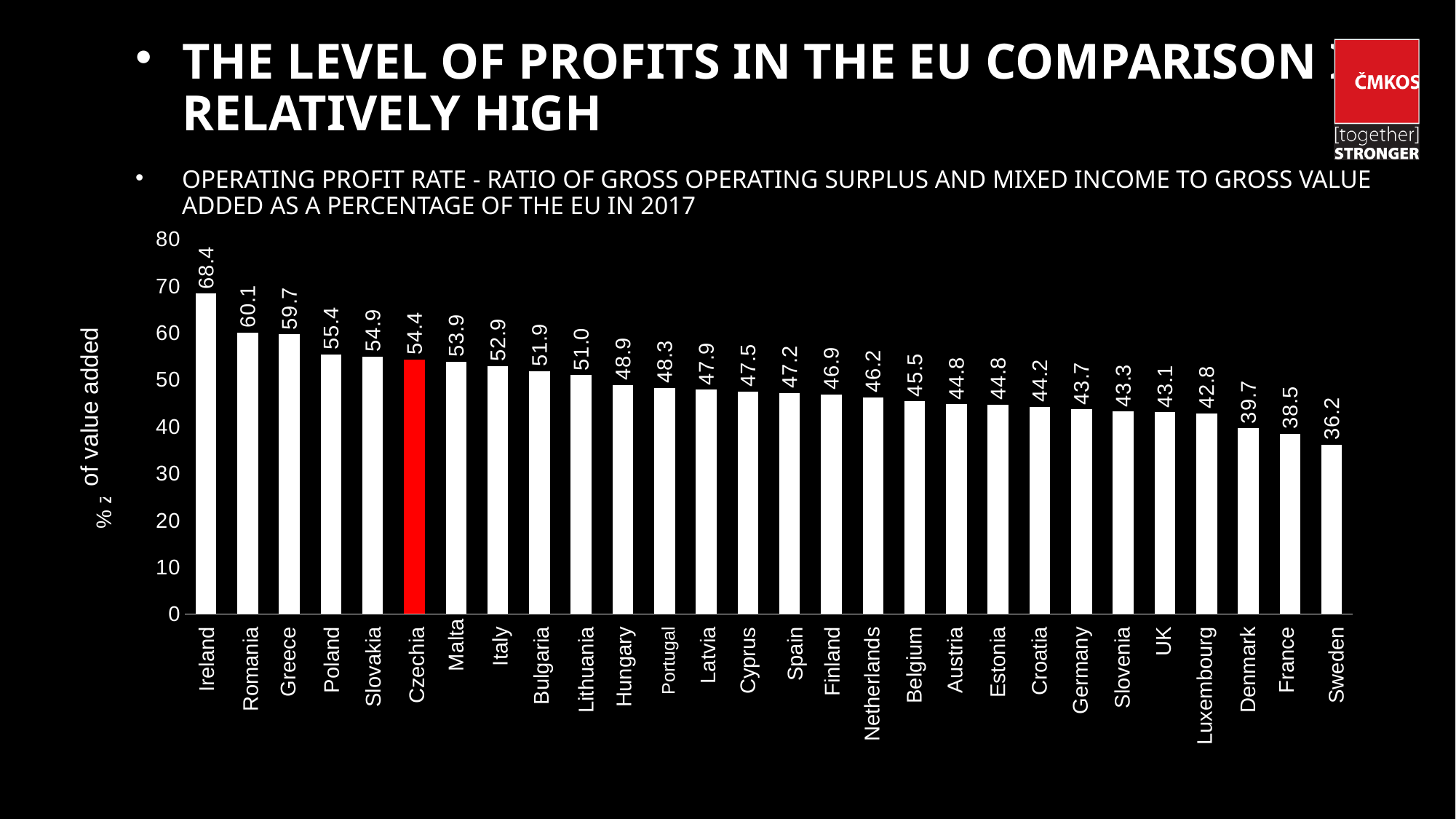
How many countries are shown in the chart? 28 Which country has the highest value? Ireland What is the value for Sweden? 36.2 What is the difference between the values for Ireland and Czechia? 14.0 Which has a larger value, Poland or Hungary? Poland Which country's bar is highlighted in red? Czechia Do the values rise or fall from left to right along the x axis? fall What is the value for Germany? 43.7 Which country has the lowest value? Sweden What kind of chart is shown on the slide? bar chart What is the value for Czechia? 54.4 Is the value for Denmark greater or less than 40? less